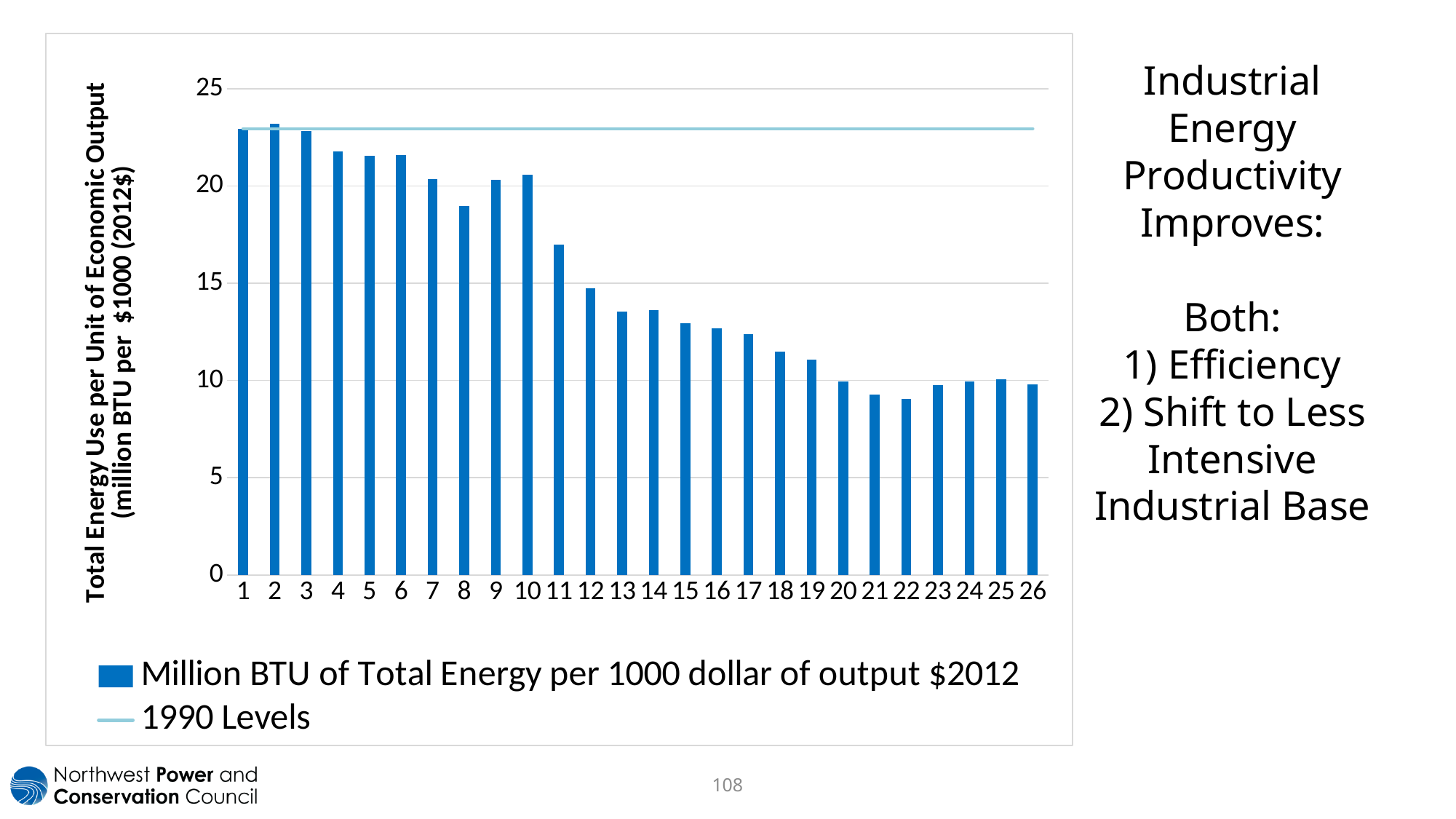
Is the value for category 11 greater or less than 15? greater What kind of chart is shown on the slide? combination bar and line chart Which has the larger value, category 8 or category 9? category 9 What does the horizontal line in the chart represent, according to the legend? 1990 Levels Do the bar values generally rise or fall from category 1 to category 26? fall Is the value for category 8 greater or less than 20? less Is the value for category 1 greater or less than 20? greater Which has the larger value, category 1 or category 26? category 1 How many categories are shown along the x axis of the chart? 26 How many series does the chart's legend list? 2